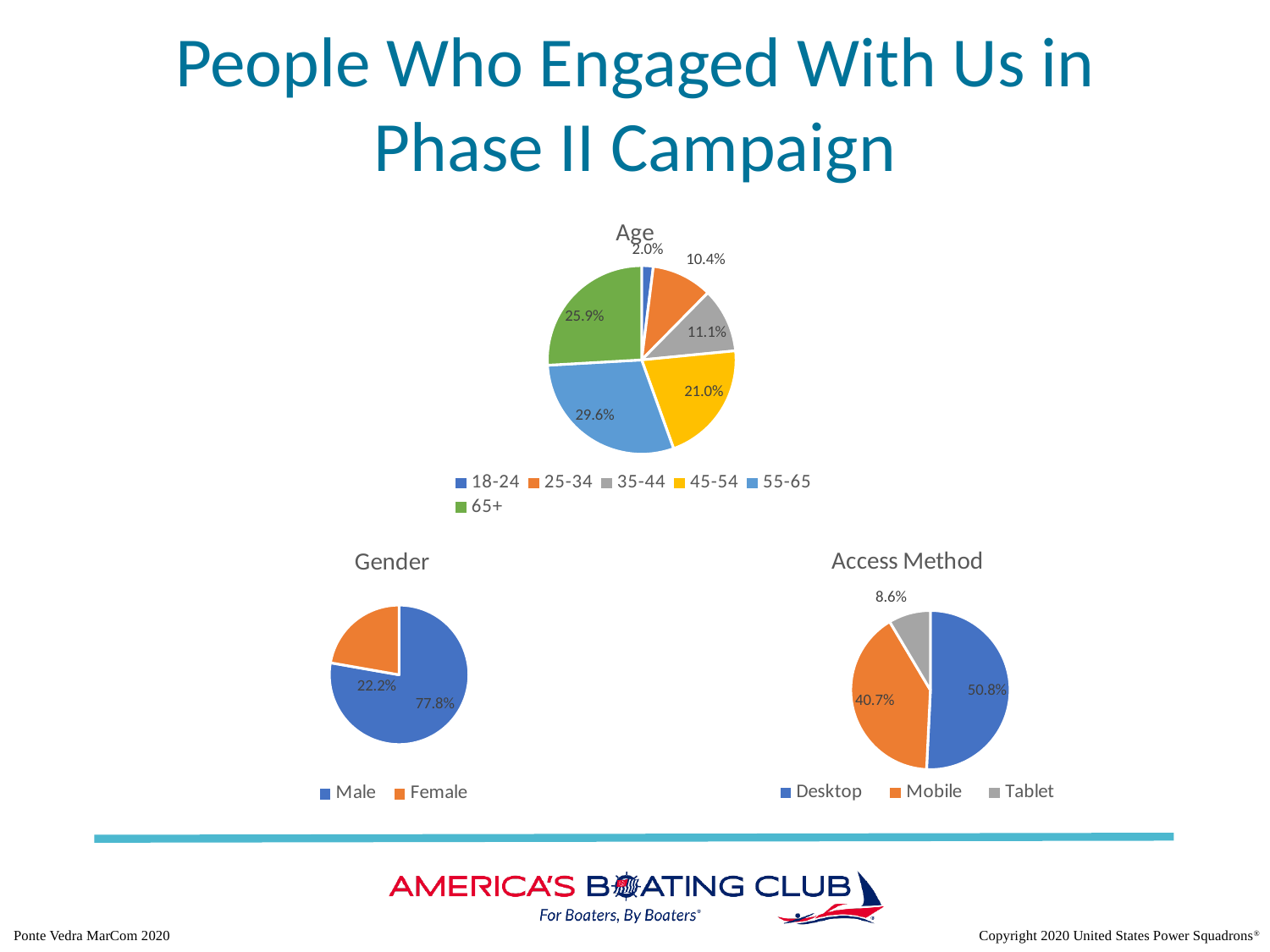
In the Age chart, which age group has the largest share? 55-65 In the Age chart, which age group has the smallest share? 18-24 In the Age chart, what share of people were aged 55-65? 29.6% In the Age chart, how many age groups are shown? 6 What kind of chart is the Access Method chart? Pie chart In the Age chart, what share of people were aged 18-24? 2.0% In the Gender chart, which gender has the larger share? Male In the Gender chart, what share of people were female? 22.2% In the Access Method chart, what share of people used mobile? 40.7% In the Access Method chart, which access method has the smallest share? Tablet In the Age chart, what is the difference between the 45-54 share and the 35-44 share? 9.9% In the Access Method chart, what is the difference between the Desktop share and the Mobile share? 10.1%